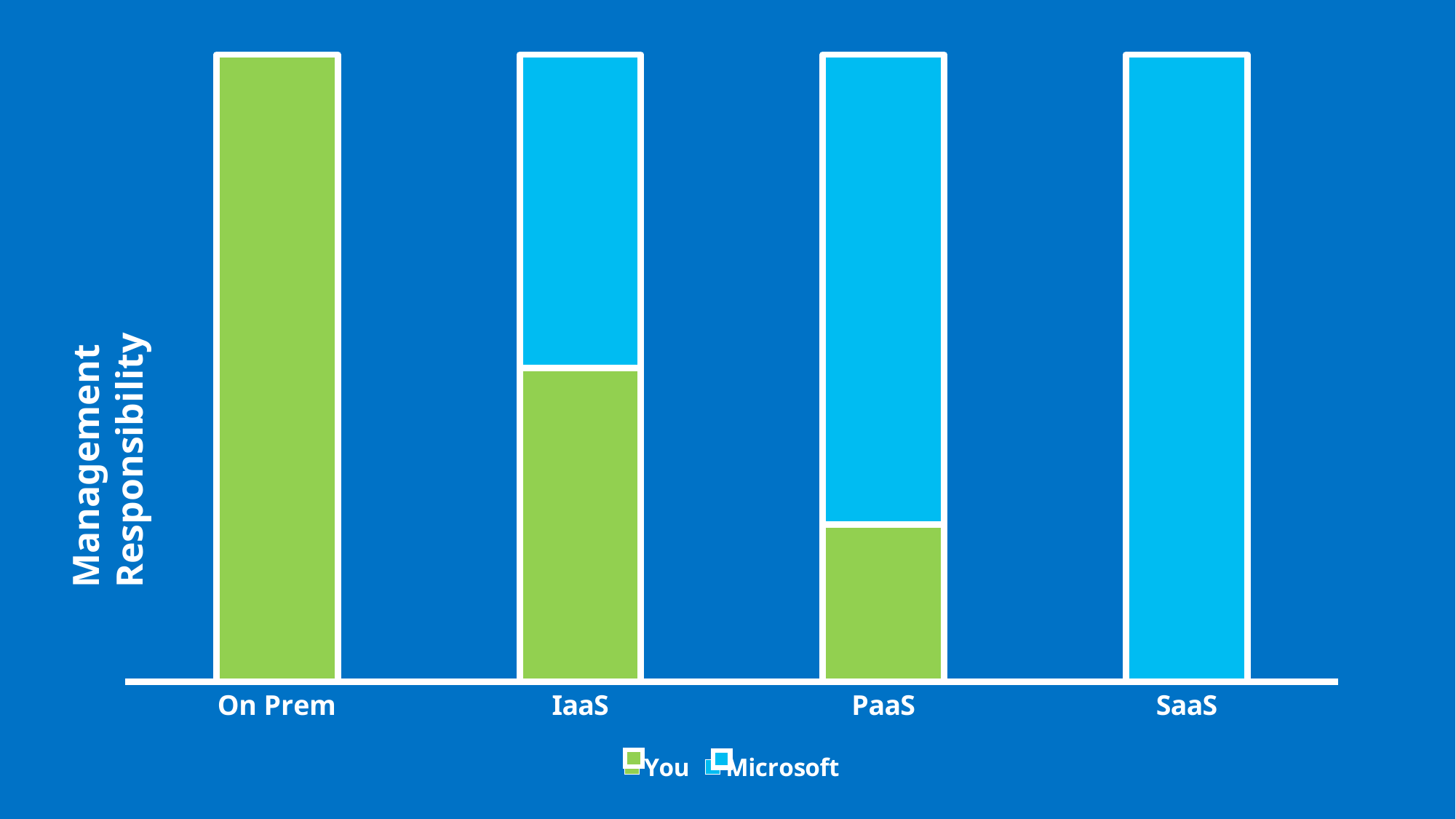
How many categories are shown along the x axis? 4 What kind of chart is shown on the slide? Stacked bar chart What are the two series named in the legend? You and Microsoft Which category has the smallest 'You' portion? SaaS Does the 'You' portion rise or fall moving from On Prem to SaaS along the x axis? Fall What is the title of the vertical axis? Management Responsibility How many series does the legend list? 2 Is the 'Microsoft' portion larger for PaaS or for IaaS? PaaS Is the 'You' portion larger for IaaS or for PaaS? IaaS Which category has the smallest 'Microsoft' portion? On Prem Which category has the largest 'You' portion? On Prem Which category has the largest 'Microsoft' portion? SaaS